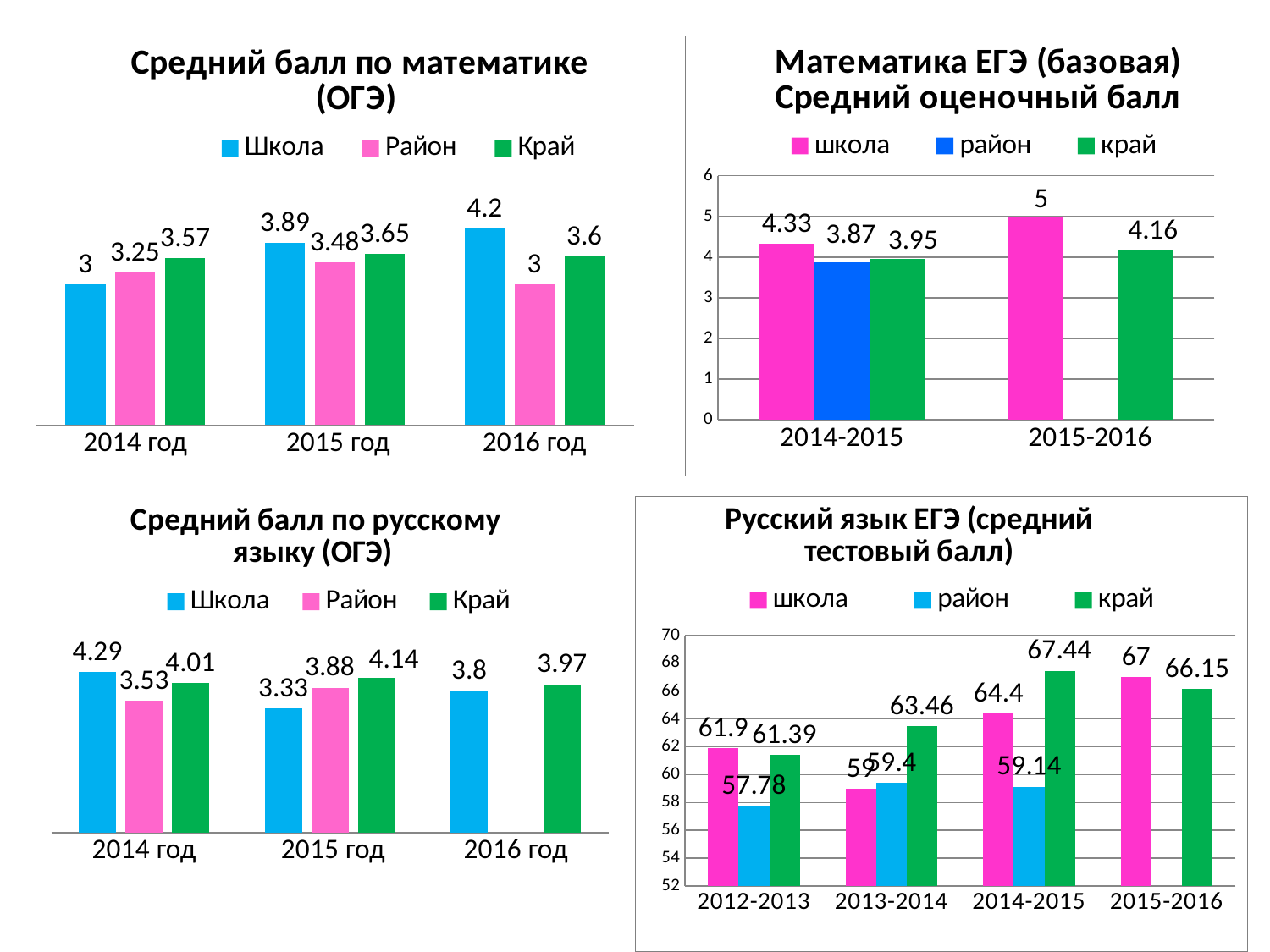
In the chart 'Математика ЕГЭ (базовая) Средний оценочный балл', what is the value for школа in 2015-2016? 5 In the chart 'Средний балл по русскому языку (ОГЭ)', what is the value for Район in 2015 год? 3.88 In the chart 'Средний балл по математике (ОГЭ)', which year has the highest value for Школа? 2016 год In the chart 'Математика ЕГЭ (базовая) Средний оценочный балл', which series has the lowest value in 2014-2015? район What type of chart is 'Русский язык ЕГЭ (средний тестовый балл)'? bar chart In the chart 'Русский язык ЕГЭ (средний тестовый балл)', does the value for школа rise or fall from 2013-2014 to 2015-2016? rise In the chart 'Средний балл по русскому языку (ОГЭ)', which is larger in 2014 год, Школа or Край? Школа In the chart 'Средний балл по математике (ОГЭ)', what is the difference between Край and Район in 2014 год? 0.32 In the chart 'Средний балл по математике (ОГЭ)', what is the value for Школа in 2016 год? 4.2 In the chart 'Средний балл по русскому языку (ОГЭ)', how many year categories are shown on the x axis? 3 In the chart 'Русский язык ЕГЭ (средний тестовый балл)', what is the value for край in 2014-2015? 67.44 In the chart 'Математика ЕГЭ (базовая) Средний оценочный балл', how many series does the legend list? 3